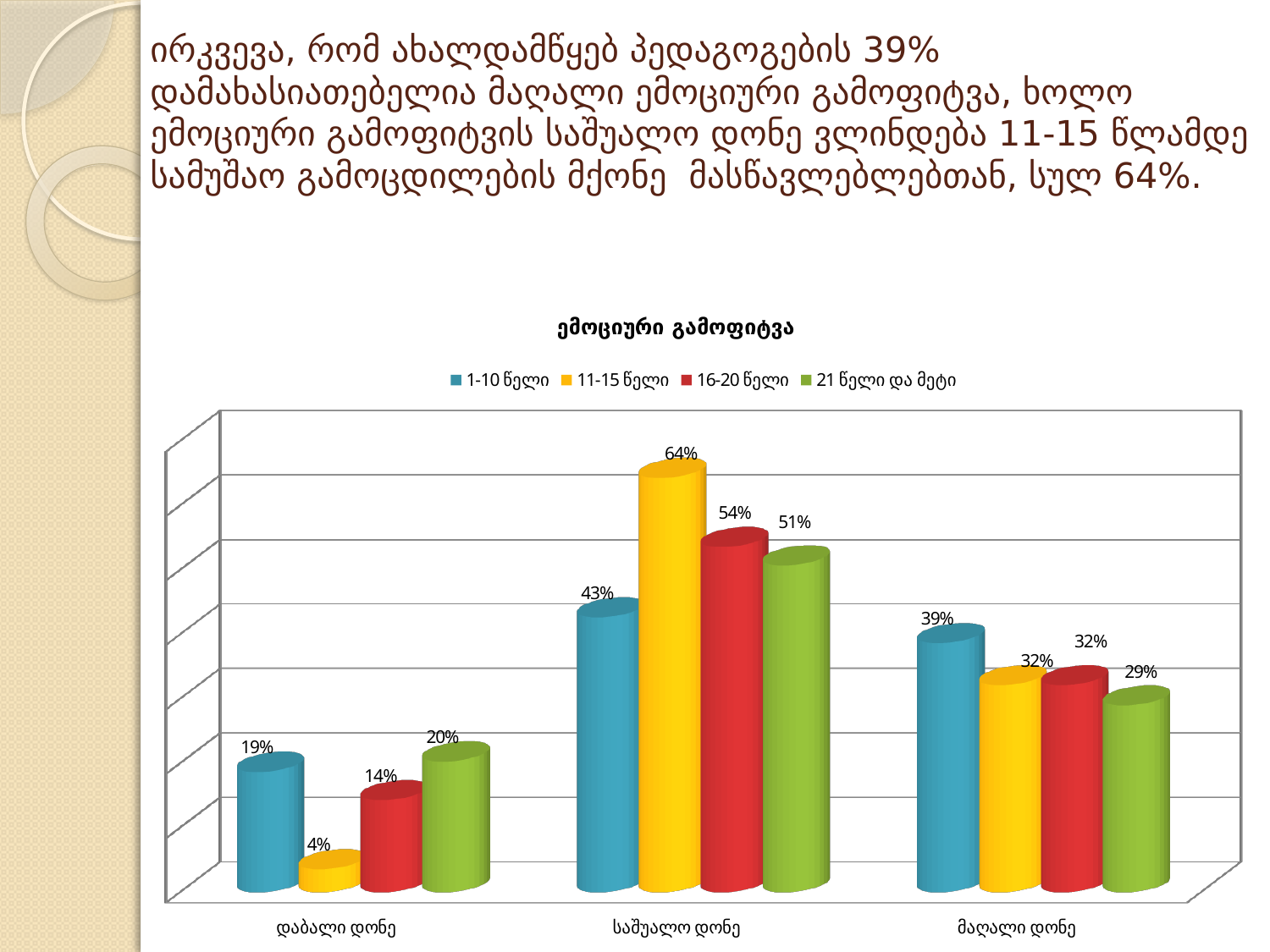
What is the title of the chart? ემოციური გამოფიტვა Which series has the highest value in the საშუალო დონე category? 11-15 წელი How many series does the legend list? 4 What kind of chart is shown on the slide? Bar chart What is the difference between the 11-15 წელი and 1-10 წელი values in the საშუალო დონე category? 21% What is the value for 1-10 წელი in the მაღალი დონე category? 39% What is the value for 21 წელი და მეტი in the საშუალო დონე category? 51% Which is larger in the მაღალი დონე category: the value for 1-10 წელი or the value for 21 წელი და მეტი? 1-10 წელი How many categories are shown on the x axis? 3 What is the value for 11-15 წელი in the საშუალო დონე category? 64% Which series has the lowest value in the დაბალი დონე category? 11-15 წელი What is the value for 16-20 წელი in the დაბალი დონე category? 14%